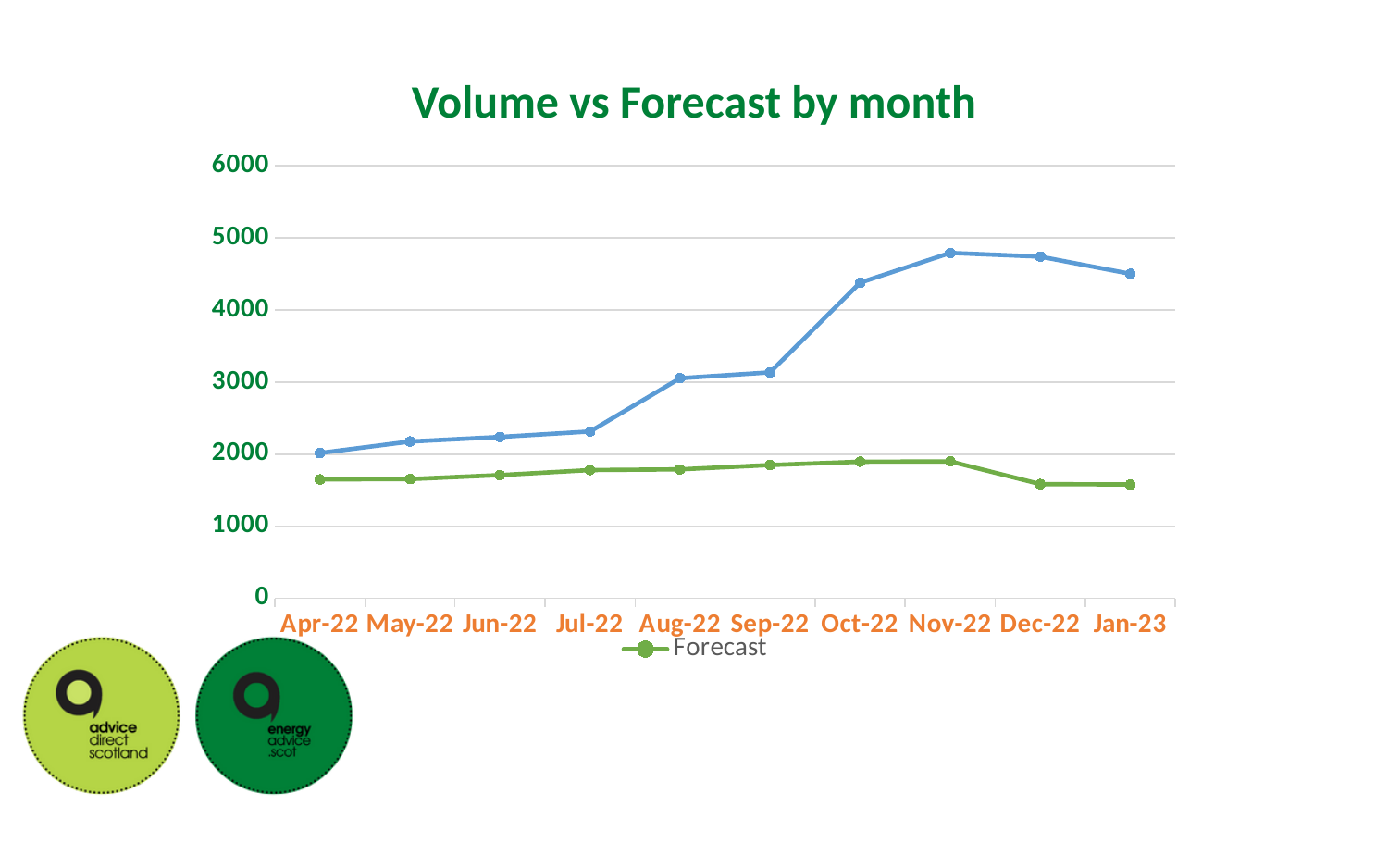
How many months are plotted along the x axis? 10 How many series does the legend list? 1 Is the value of the blue line for Jan-23 greater or less than 5000? less What kind of chart is shown on the slide? line chart Does the blue line rise or fall from Apr-22 to Nov-22? rise In Nov-22, which is larger: the blue line value or the Forecast value? the blue line value Is the value of the blue line for Oct-22 greater or less than 4000? greater What is the title of the chart? Volume vs Forecast by month Is the value of the blue line for Sep-22 greater or less than 3000? greater In which month is the blue line at its lowest value? Apr-22 Which series name appears in the legend? Forecast